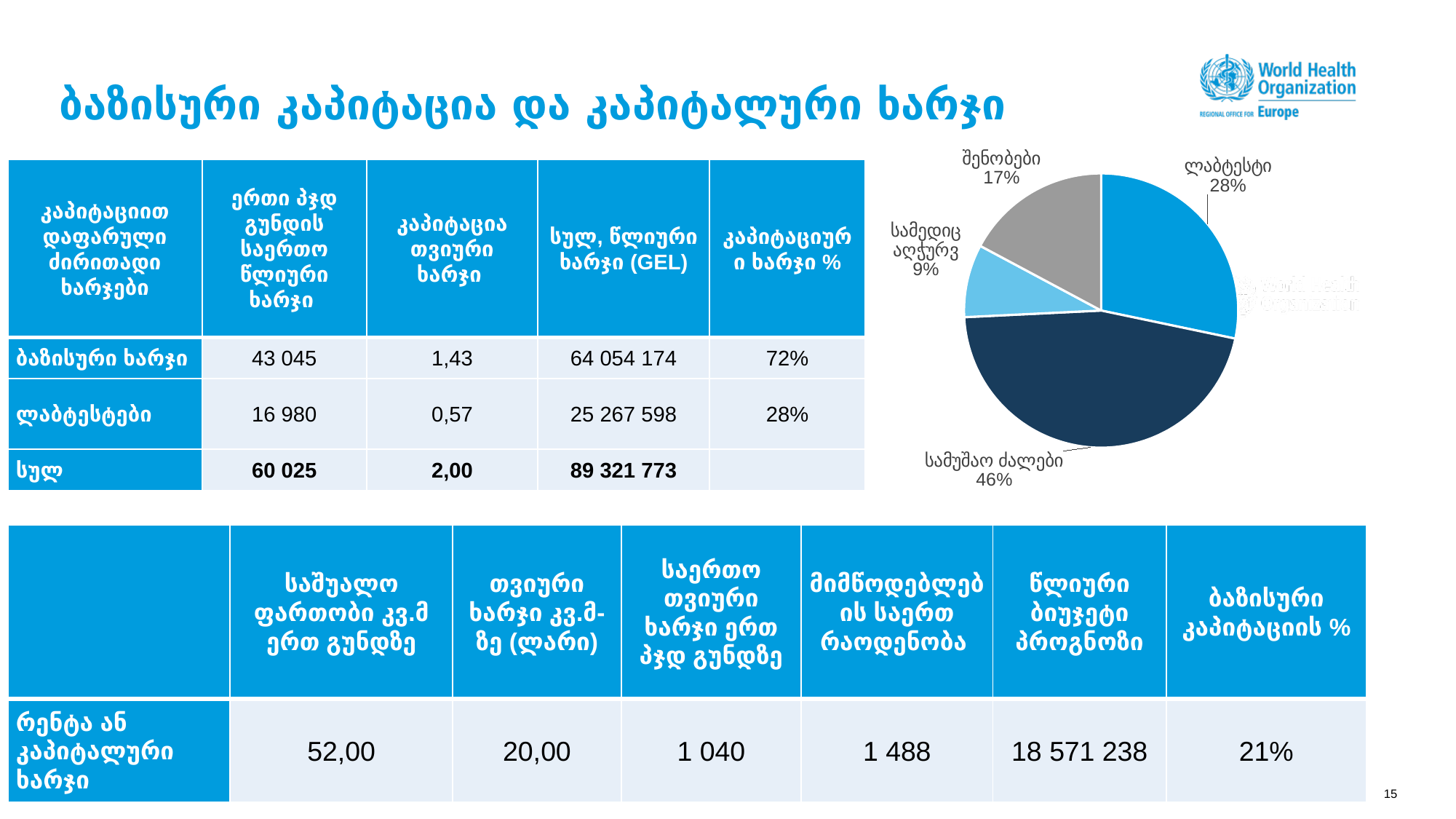
What colour is the სამუშაო ძალები slice in the pie chart? dark navy blue In the pie chart, what is the difference in percentage points between შენობები and სამედიც აღჭურვ? 8 What kind of chart is shown on the right side of the slide? pie chart What share of the pie chart is labelled სამუშაო ძალები? 46% How many slices does the pie chart have? 4 What share of the pie chart is labelled სამედიც აღჭურვ? 9% Which slice of the pie chart is the smallest? სამედიც აღჭურვ What share of the pie chart is labelled შენობები? 17% Which slice of the pie chart is the largest? სამუშაო ძალები In the pie chart, what is the difference in percentage points between სამუშაო ძალები and ლაბტესტი? 18 In the pie chart, which is larger: ლაბტესტი or შენობები? ლაბტესტი